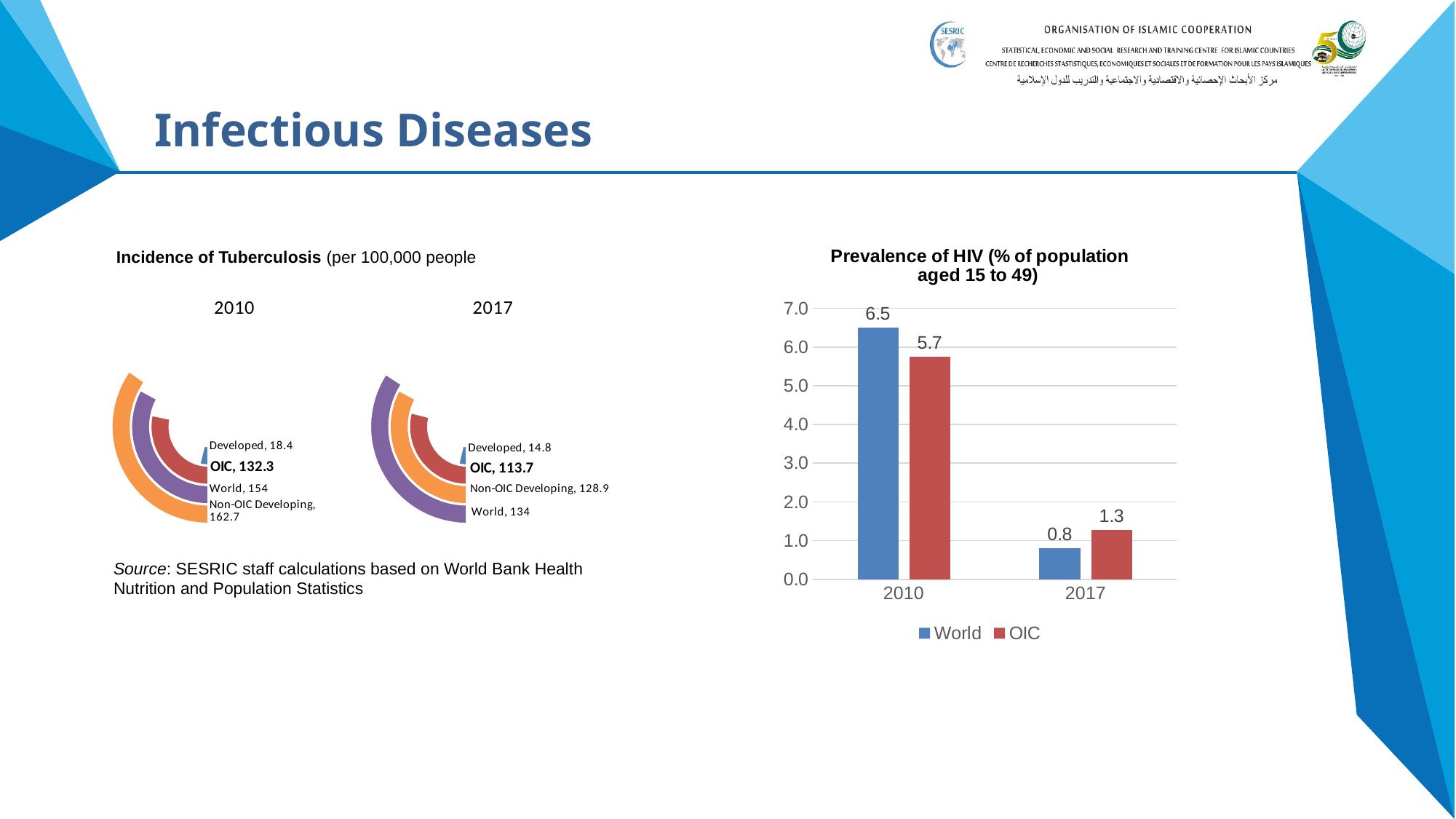
In the Incidence of Tuberculosis chart for 2017, which group has the lowest value? Developed In the Incidence of Tuberculosis chart for 2017, what is the value for Non-OIC Developing? 128.9 In the Incidence of Tuberculosis chart for 2010, which group has the highest value? Non-OIC Developing In the Incidence of Tuberculosis chart for 2017, which is larger, the value for World or for Non-OIC Developing? World How many groups are shown in the Incidence of Tuberculosis chart for 2010? 4 In the Incidence of Tuberculosis chart for 2010, what is the value for OIC? 132.3 In the Prevalence of HIV chart, what is the difference between the World and OIC values in 2017? 0.5 In the Prevalence of HIV chart, how many series does the legend list? 2 In the Incidence of Tuberculosis charts, by how much did the OIC value fall from 2010 to 2017? 18.6 What kind of chart is the Prevalence of HIV chart? Bar chart In the Prevalence of HIV chart, what is the value for OIC in 2010? 5.7 In the Prevalence of HIV chart, what is the value for World in 2017? 0.8